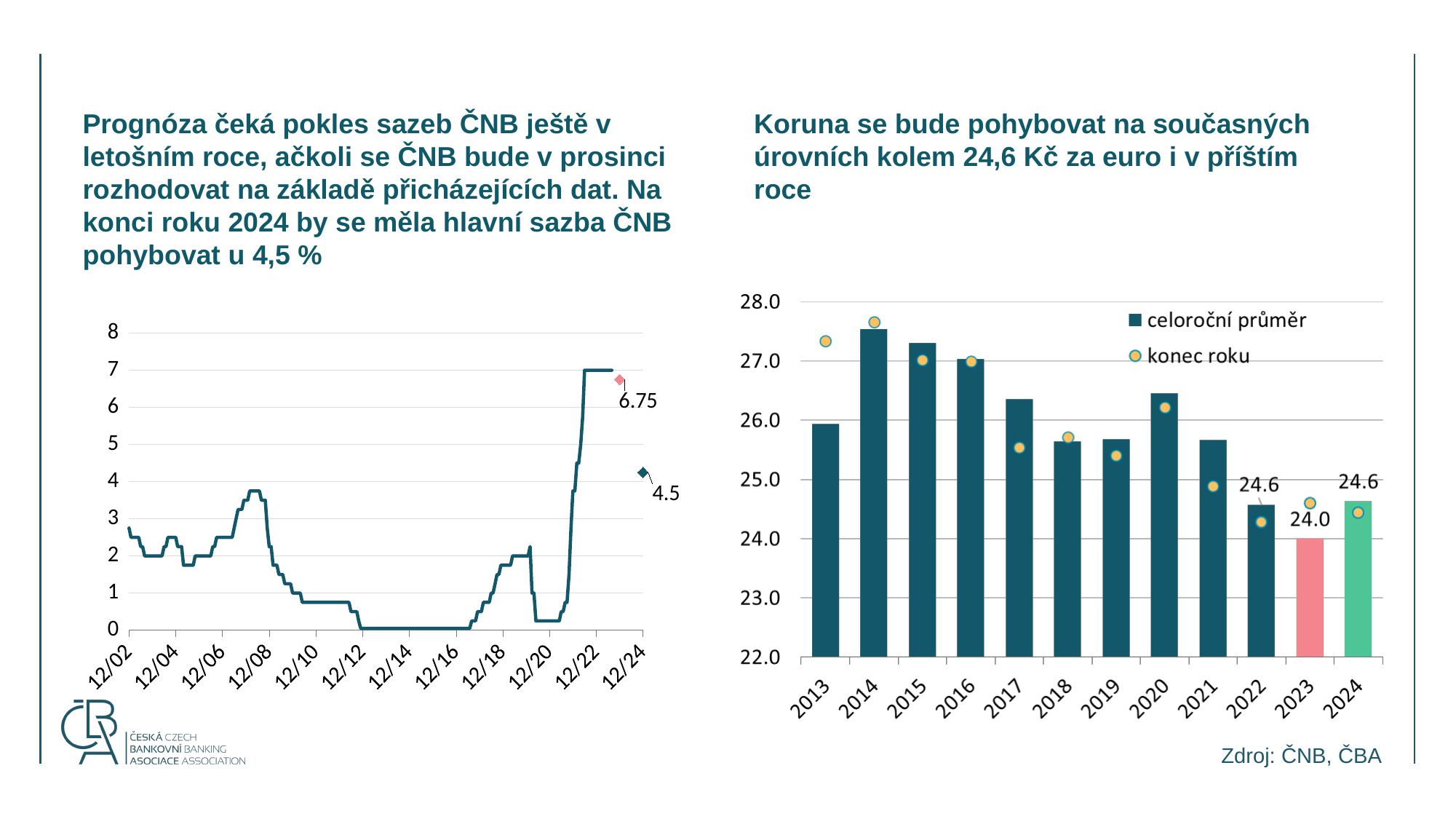
On the left chart, what value is labelled at the lower marker near 12/24? 4.5 What kind of chart is the right chart showing the koruna exchange rate? bar chart On the left chart, is the value of the line at 12/22 greater or less than 6? greater On the right chart, what is the labelled value of the bar for 2023? 24.0 On the right chart, how many years are shown on the x axis? 12 On the right chart, which year has the lowest bar? 2023 On the right chart, how many series does the legend list? 2 On the right chart, what is the difference between the labelled bar values for 2024 and 2023? 0.6 On the left chart, is the value of the line at 12/14 greater or less than 1? less On the right chart, which year has the highest bar? 2014 What kind of chart is the left chart showing ČNB rates? line chart On the left chart, what value is labelled at the upper marker near 12/24? 6.75